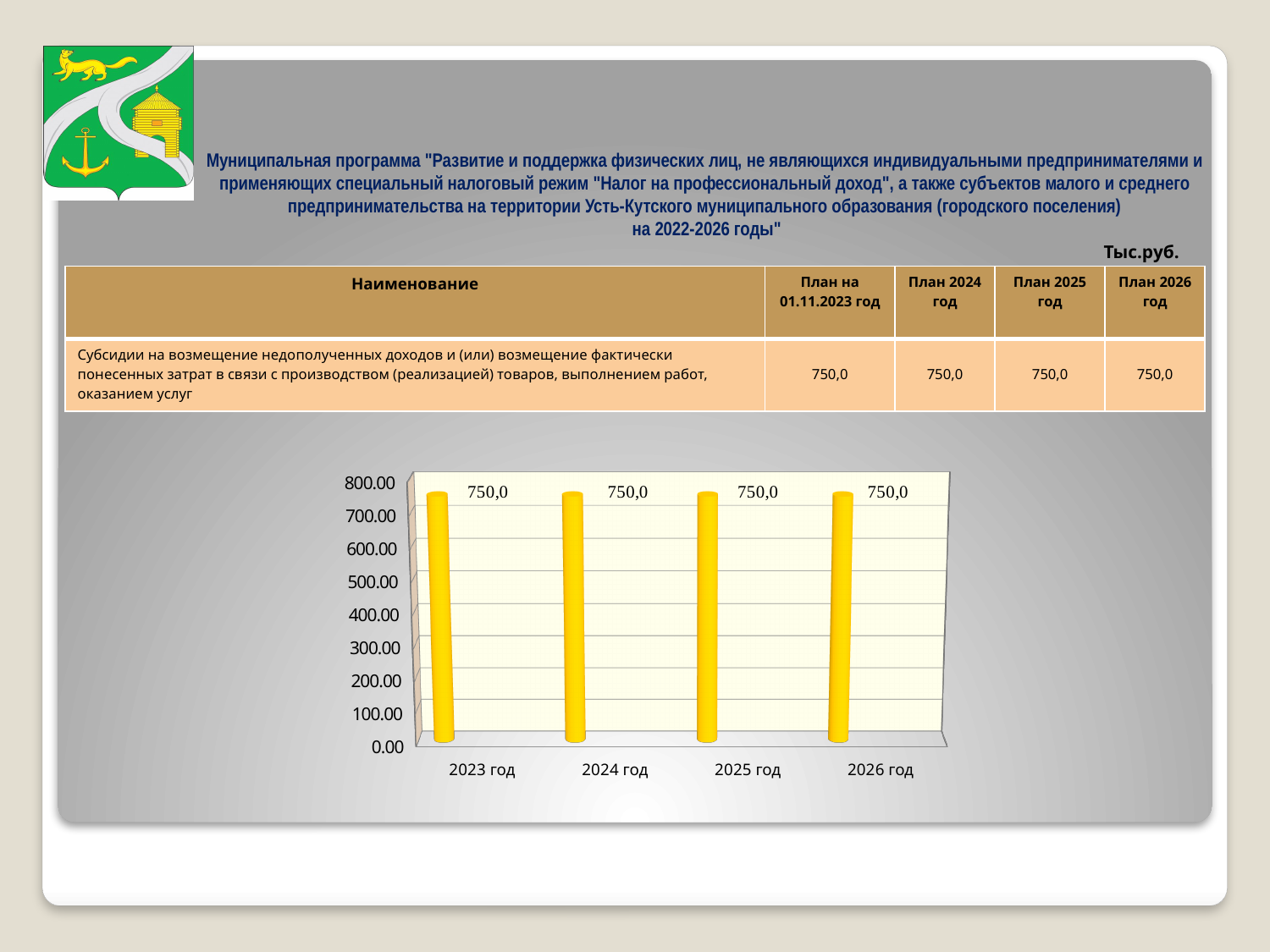
What is the value for 2025 год? 750,0 Do the values rise, fall or stay the same from 2023 год to 2026 год? stay the same Is the value for 2023 год greater or less than 800.00? less What kind of chart is shown on the slide? bar chart What is the difference between the values for 2026 год and 2023 год? 0,0 What is the value for 2026 год? 750,0 Is the value for 2025 год greater or less than 700.00? greater How many categories are shown on the x axis of the chart? 4 What is the highest value shown on the vertical axis of the chart? 800.00 What is the value for 2023 год? 750,0 What is the value for 2024 год? 750,0 What colour are the bars in the chart? yellow